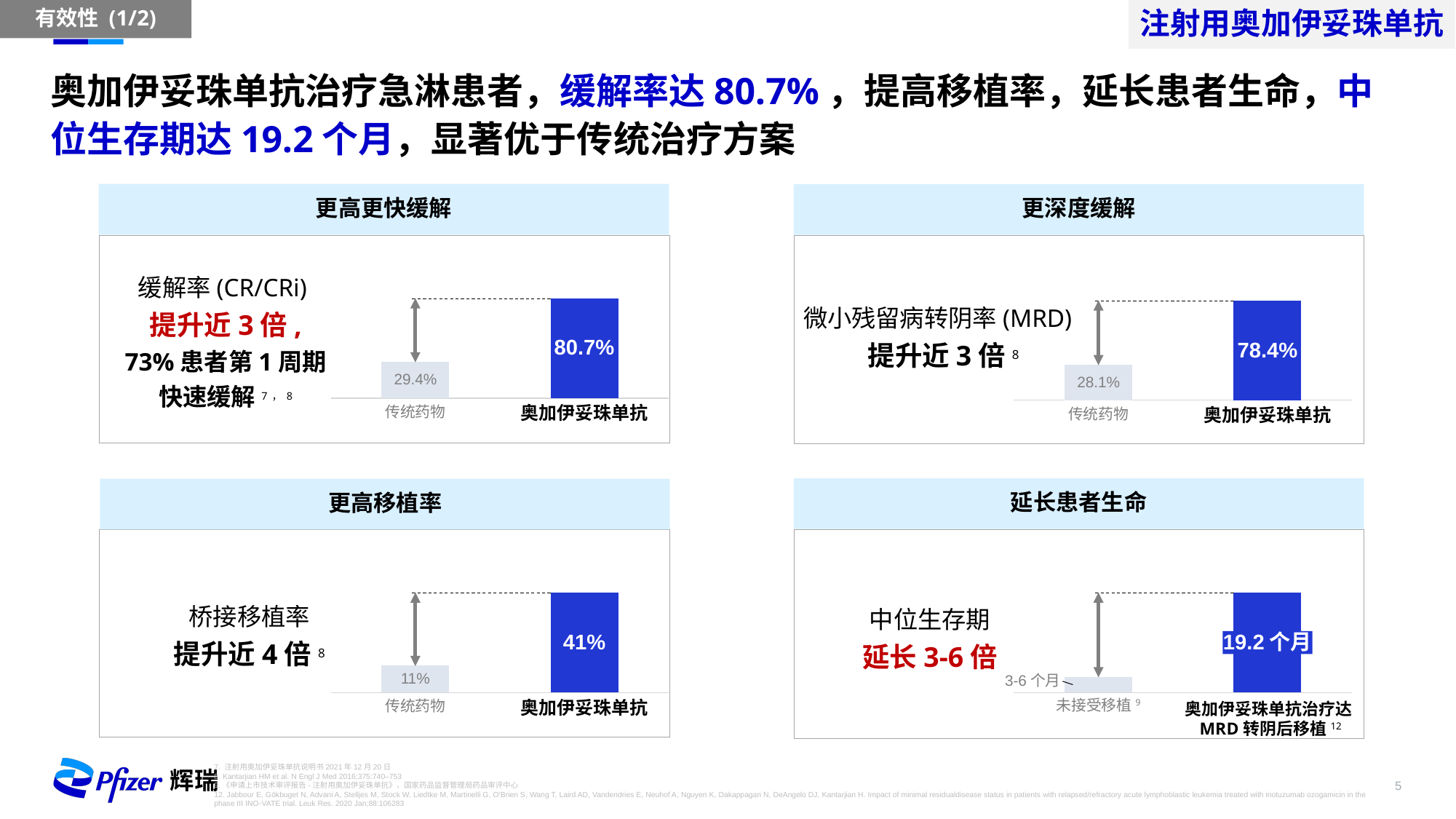
In the chart titled 更高移植率, what is the value for 奥加伊妥珠单抗? 41% In the chart titled 更高更快缓解, what is the difference between the values for 奥加伊妥珠单抗 and 传统药物? 51.3% In the chart titled 更深度缓解, what is the value for 奥加伊妥珠单抗? 78.4% What kind of chart is used in the panel titled 更高移植率? bar chart In the chart titled 更深度缓解, which category has the higher value? 奥加伊妥珠单抗 In the chart titled 更高更快缓解, what is the value for 传统药物? 29.4% In the chart titled 更高更快缓解, what is the value for 奥加伊妥珠单抗? 80.7% In the chart titled 更高移植率, what is the value for 传统药物? 11% In the chart titled 更高移植率, what is the difference between the values for 奥加伊妥珠单抗 and 传统药物? 30% In the chart titled 延长患者生命, what is the median survival shown for 奥加伊妥珠单抗治疗达MRD转阴后移植? 19.2 个月 In the chart titled 延长患者生命, which category has the lower value? 未接受移植 In the chart titled 更深度缓解, what is the value for 传统药物? 28.1%